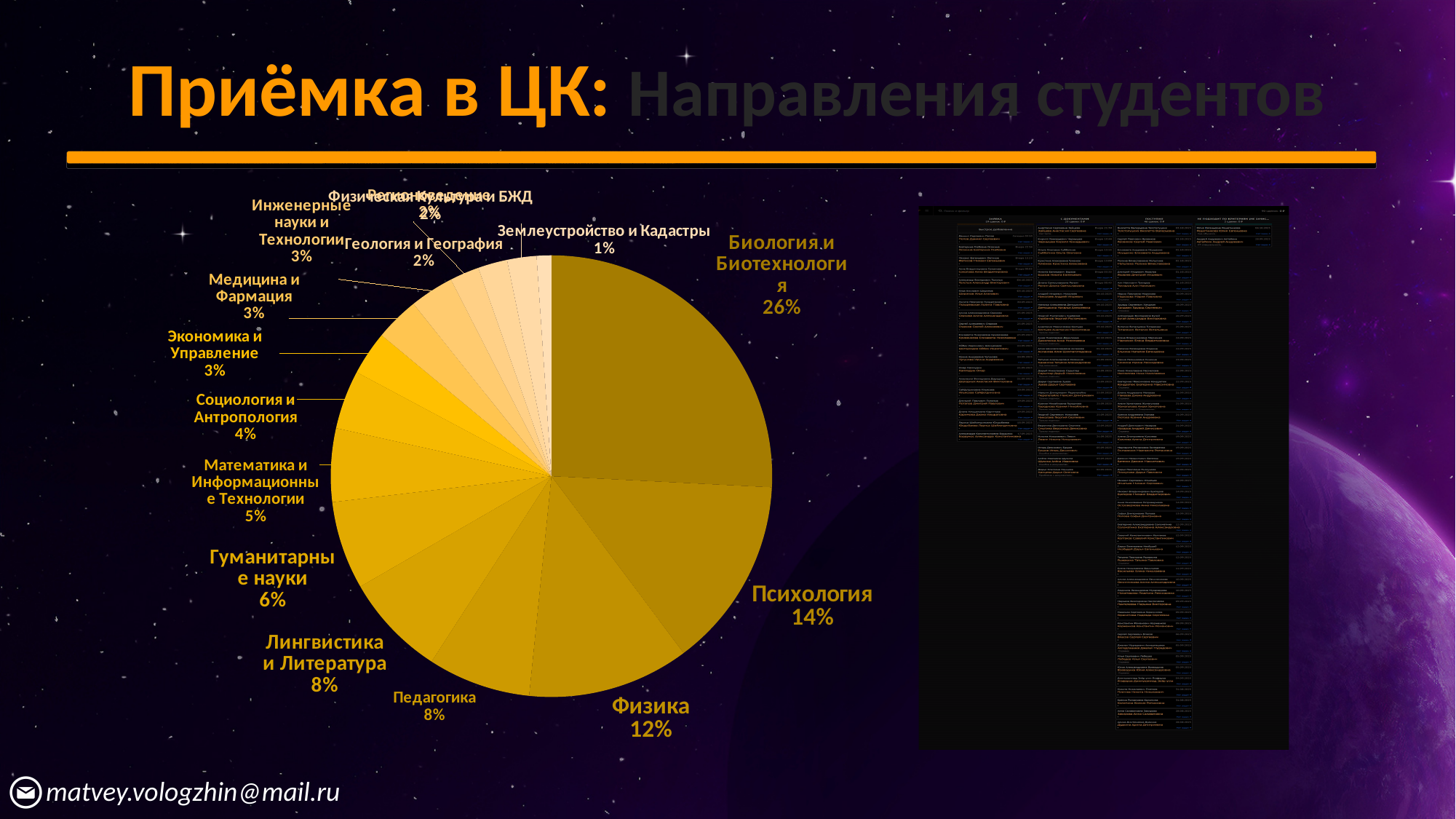
Which category has the smallest slice of the pie chart? Землеустройство и Кадастры What percentage is shown for Математика и Информационные Технологии? 5% What percentage is shown for Физика? 12% What share of the pie chart does Биология и Биотехнология account for? 26% What is the difference in percentage points between Психология and Физика? 2 percentage points What percentage is shown for Психология? 14% Which category has the largest slice of the pie chart? Биология и Биотехнология What type of chart is shown on the slide? Pie chart What is the difference in percentage points between Биология и Биотехнология and Психология? 12 percentage points What share of the pie chart does Гуманитарные науки account for? 6% What percentage is shown for Социология и Антропология? 4% Which slice is larger, Физика or Педагогика? Физика